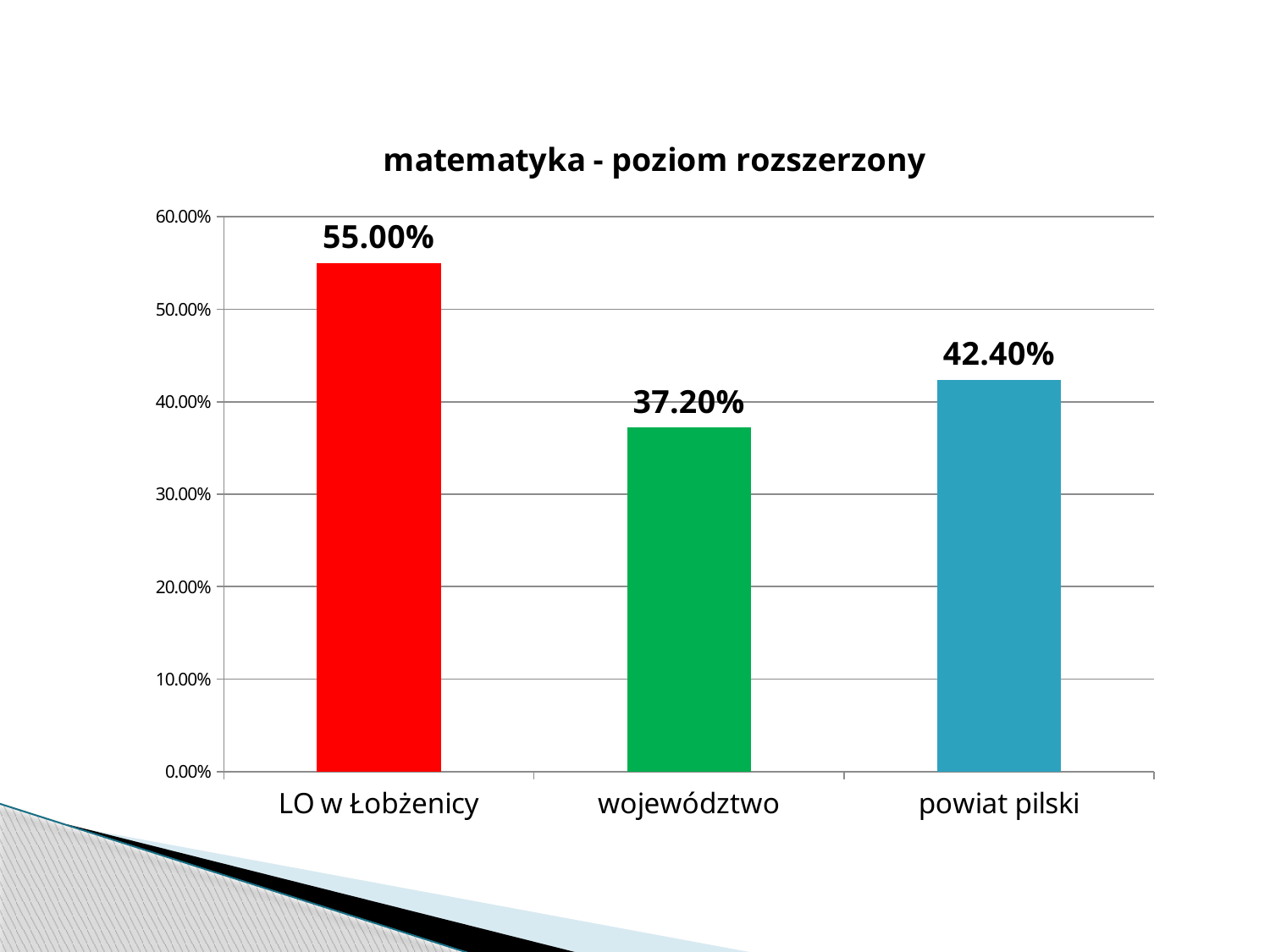
Which category has the lowest value? województwo What kind of chart is shown on the slide? bar chart Is the value for powiat pilski greater or less than 40.00%? greater Which category has the highest value? LO w Łobżenicy What is the difference between the values for powiat pilski and województwo? 5.20% How many categories are shown on the chart? 3 What is the difference between the values for LO w Łobżenicy and województwo? 17.80% Which is larger, the value for powiat pilski or the value for województwo? powiat pilski What is the value for województwo? 37.20% What is the value for powiat pilski? 42.40% What is the title of the chart? matematyka - poziom rozszerzony What is the value for LO w Łobżenicy? 55.00%